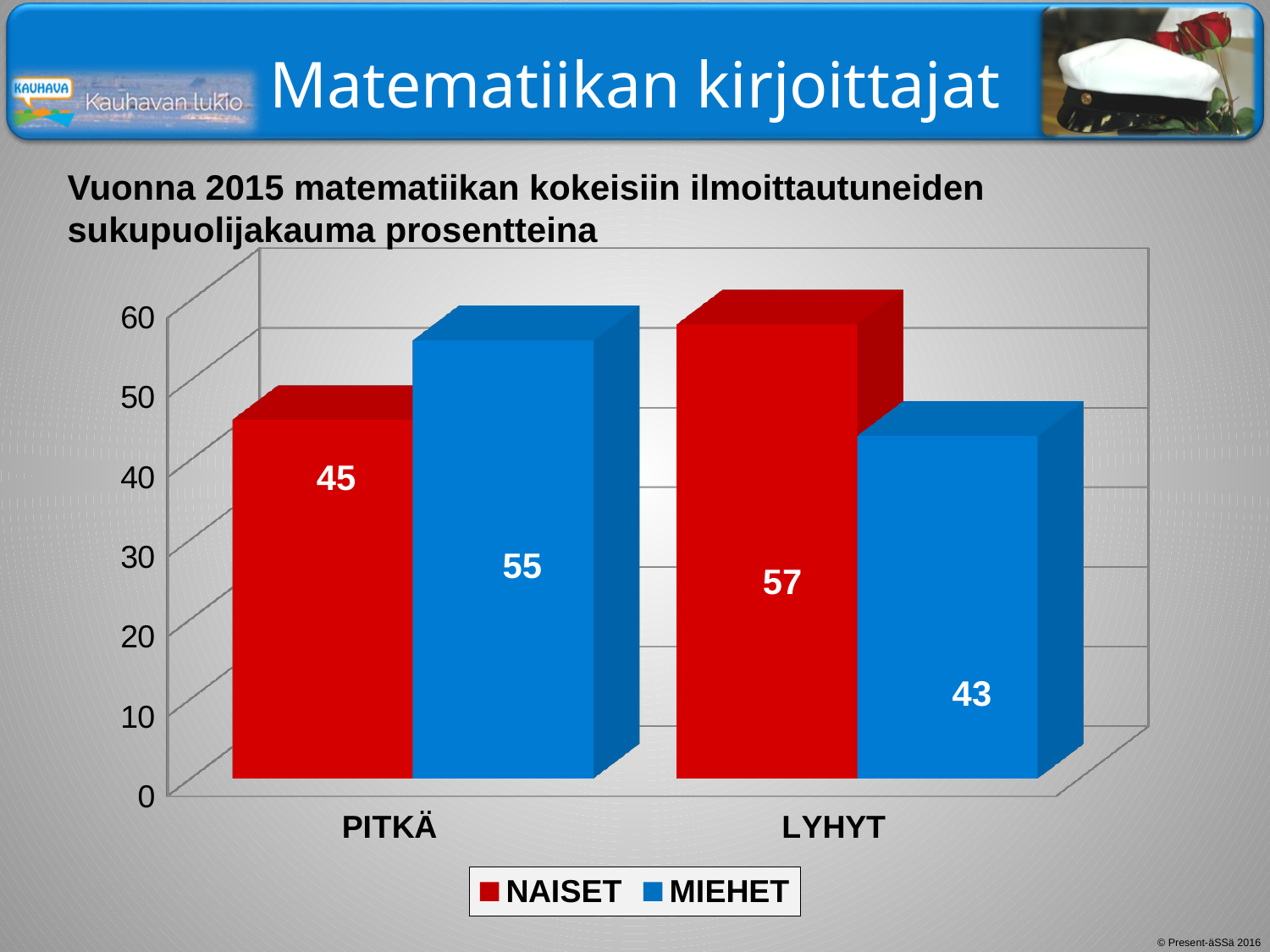
What is the difference between the NAISET and MIEHET values in the LYHYT category? 14 What is the value for NAISET in the PITKÄ category? 45 What is the difference between the MIEHET and NAISET values in the PITKÄ category? 10 What is the value for NAISET in the LYHYT category? 57 Which category has the lowest value for MIEHET? LYHYT Which is larger in the LYHYT category, NAISET or MIEHET? NAISET How many series does the legend list? 2 What is the value for MIEHET in the LYHYT category? 43 What is the value for MIEHET in the PITKÄ category? 55 Which category has the highest value for NAISET? LYHYT How many categories are shown on the x axis? 2 What kind of chart is shown on the slide? Bar chart